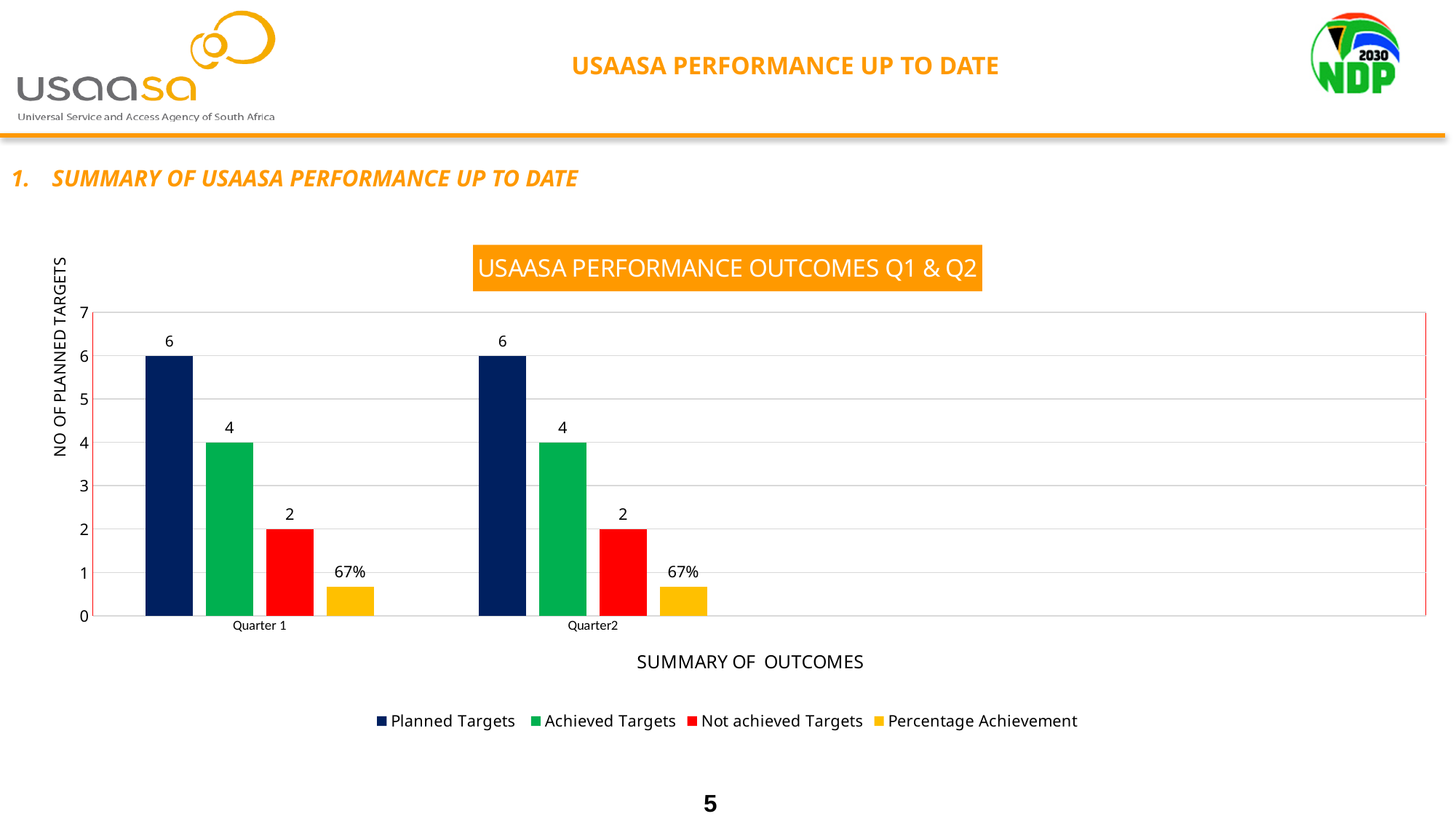
What kind of chart is shown on the slide? Bar chart What is the value of Not achieved Targets for Quarter 1? 2 What is the difference between Planned Targets and Achieved Targets in Quarter2? 2 How many series does the legend list? 4 What is the Percentage Achievement shown for Quarter2? 67% How many quarters are shown on the x axis? 2 What is the value of Planned Targets for Quarter 1? 6 Which is larger in Quarter 1: Achieved Targets or Not achieved Targets? Achieved Targets Is the value for Not achieved Targets in Quarter2 greater or less than 3? less What is the value of Achieved Targets for Quarter2? 4 What is the title of the chart? USAASA PERFORMANCE OUTCOMES Q1 & Q2 Which series has the highest value in Quarter 1? Planned Targets